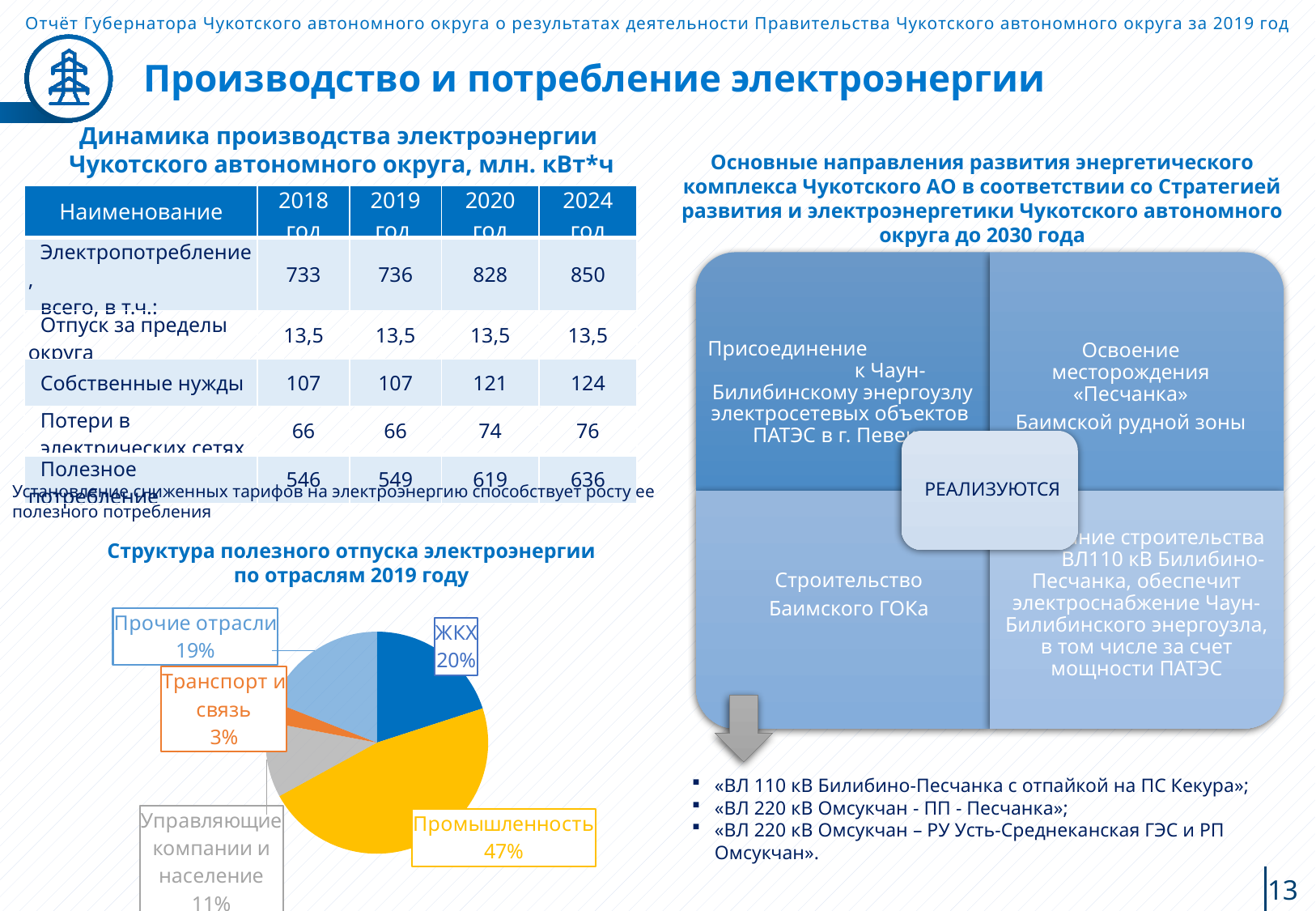
In the pie chart, what share does "Управляющие компании и население" have? 11% What kind of chart is shown under the title "Структура полезного отпуска электроэнергии по отраслям 2019 году"? Pie chart How many slices does the pie chart have? 5 In the pie chart, what share does "Транспорт и связь" have? 3% In the pie chart, what share does "ЖКХ" have? 20% In the pie chart, what is the difference in percentage points between "Промышленность" and "ЖКХ"? 27 Which sector has the largest slice in the pie chart? Промышленность In the pie chart, which is larger: "ЖКХ" or "Управляющие компании и население"? ЖКХ What is the title of the pie chart on the slide? Структура полезного отпуска электроэнергии по отраслям 2019 году Which sector has the smallest slice in the pie chart? Транспорт и связь